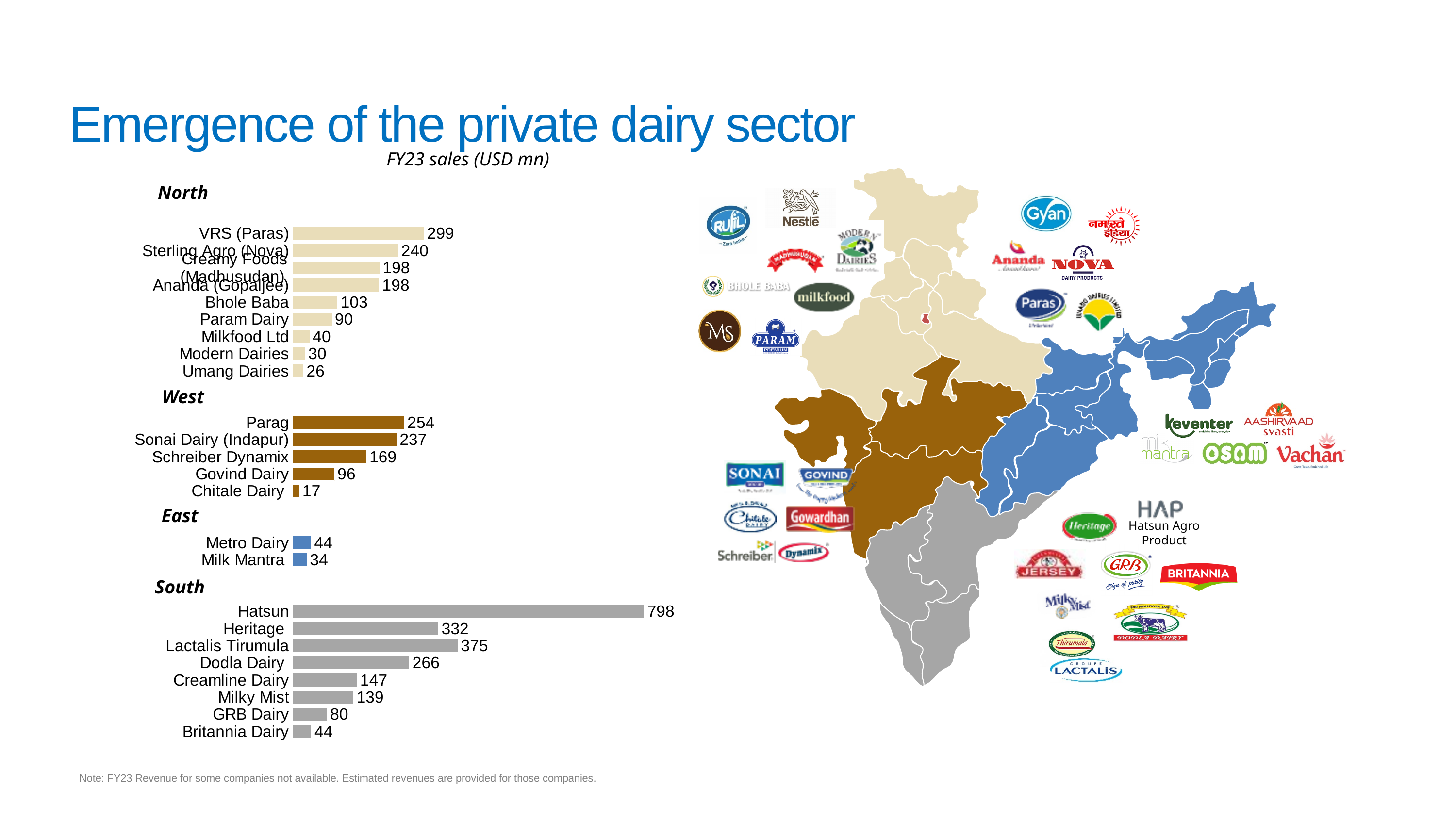
In the West chart, which company has the lowest FY23 sales? Chitale Dairy In the South chart, which company has the highest FY23 sales? Hatsun In the South chart, which has higher FY23 sales, Lactalis Tirumula or Dodla Dairy? Lactalis Tirumula In the South chart, what is the difference in FY23 sales between Hatsun and Heritage? 466 What type of chart is used to show the FY23 sales by region? Bar chart In the West chart, what is the FY23 sales value for Schreiber Dynamix? 169 In the North chart, what is the FY23 sales value for VRS (Paras)? 299 How many companies are shown in the North chart? 9 In the East chart, what is the FY23 sales value for Milk Mantra? 34 What unit are the FY23 sales figures shown in, according to the chart subtitle? USD mn In the North chart, what is the difference in FY23 sales between Sterling Agro (Nova) and Bhole Baba? 137 How many companies are shown in the East chart? 2